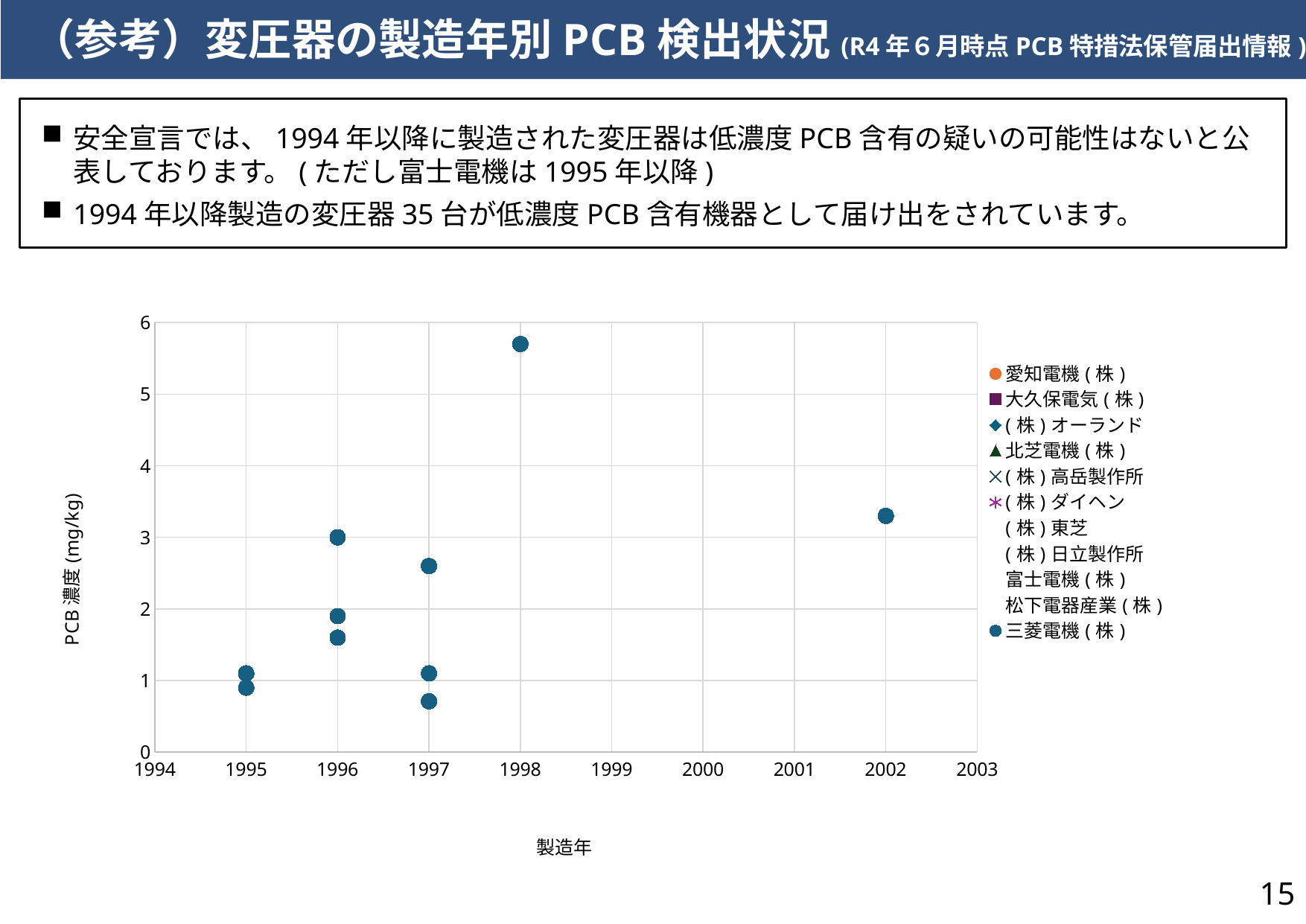
Which is larger: the point plotted at 1998 or the point plotted at 2002? 1998 What kind of chart is shown on the slide? scatter chart In which manufacturing year (製造年) is the highest PCB concentration point plotted? 1998 Is the value of the point plotted at 1998 greater or less than 5? greater Are the values of the points plotted at 1995 greater or less than 2? less In which manufacturing year (製造年) is the lowest PCB concentration point plotted? 1997 How many series does the legend list? 11 How many data points are plotted on the chart? 10 Is the value of the lowest point plotted at 1997 greater or less than 1? less What is the label of the y axis? PCB 濃度 (mg/kg) What is the label of the x axis? 製造年